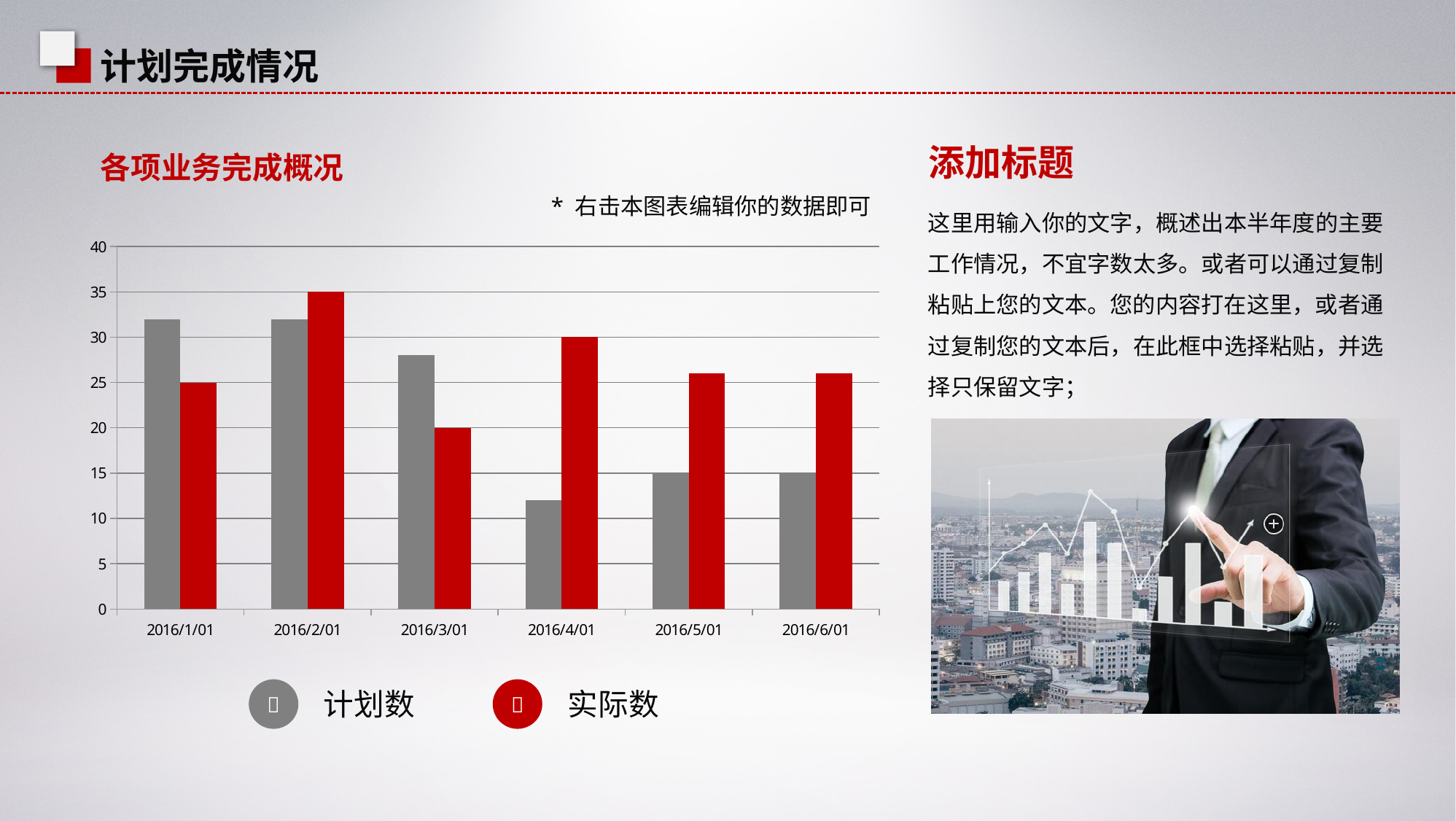
Which date has the lowest 计划数 value? 2016/4/01 Is the 计划数 value for 2016/1/01 greater or less than 30? greater What is the 实际数 value for 2016/3/01? 20 How many date categories are shown on the x axis of the chart? 6 For 2016/1/01, which is larger, 计划数 or 实际数? 计划数 What colour represents the 实际数 series in the chart? red What is the 实际数 value for 2016/2/01? 35 What is the difference between the 实际数 values for 2016/2/01 and 2016/4/01? 5 What kind of chart is shown on the slide? bar chart How many series does the chart legend list? 2 What is the 实际数 value for 2016/4/01? 30 Which date has the highest 实际数 value? 2016/2/01